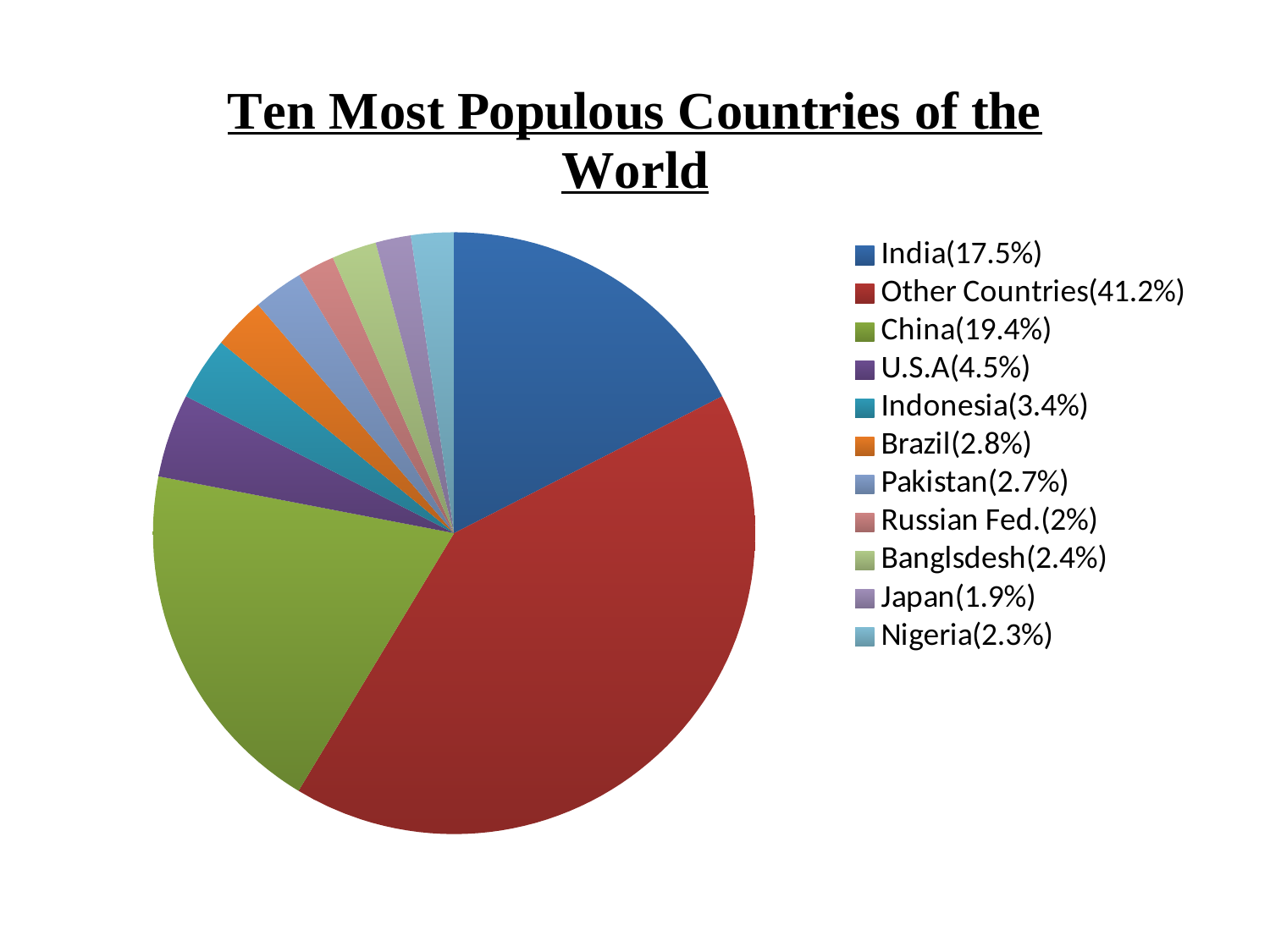
What percentage share is shown for Indonesia? 3.4% What percentage share is shown for China? 19.4% Which country has the smallest share of the pie? Japan Which has the larger share, China or India? China What percentage share does India have according to the legend? 17.5% What share of the pie does Other Countries represent? 41.2% How many slices does the pie chart have? 11 What is the title of the slide? Ten Most Populous Countries of the World Which has the larger share, U.S.A or Indonesia? U.S.A What kind of chart is shown on the slide? pie chart Which legend entry has the largest share of the pie? Other Countries What is the difference between China's share and India's share? 1.9%